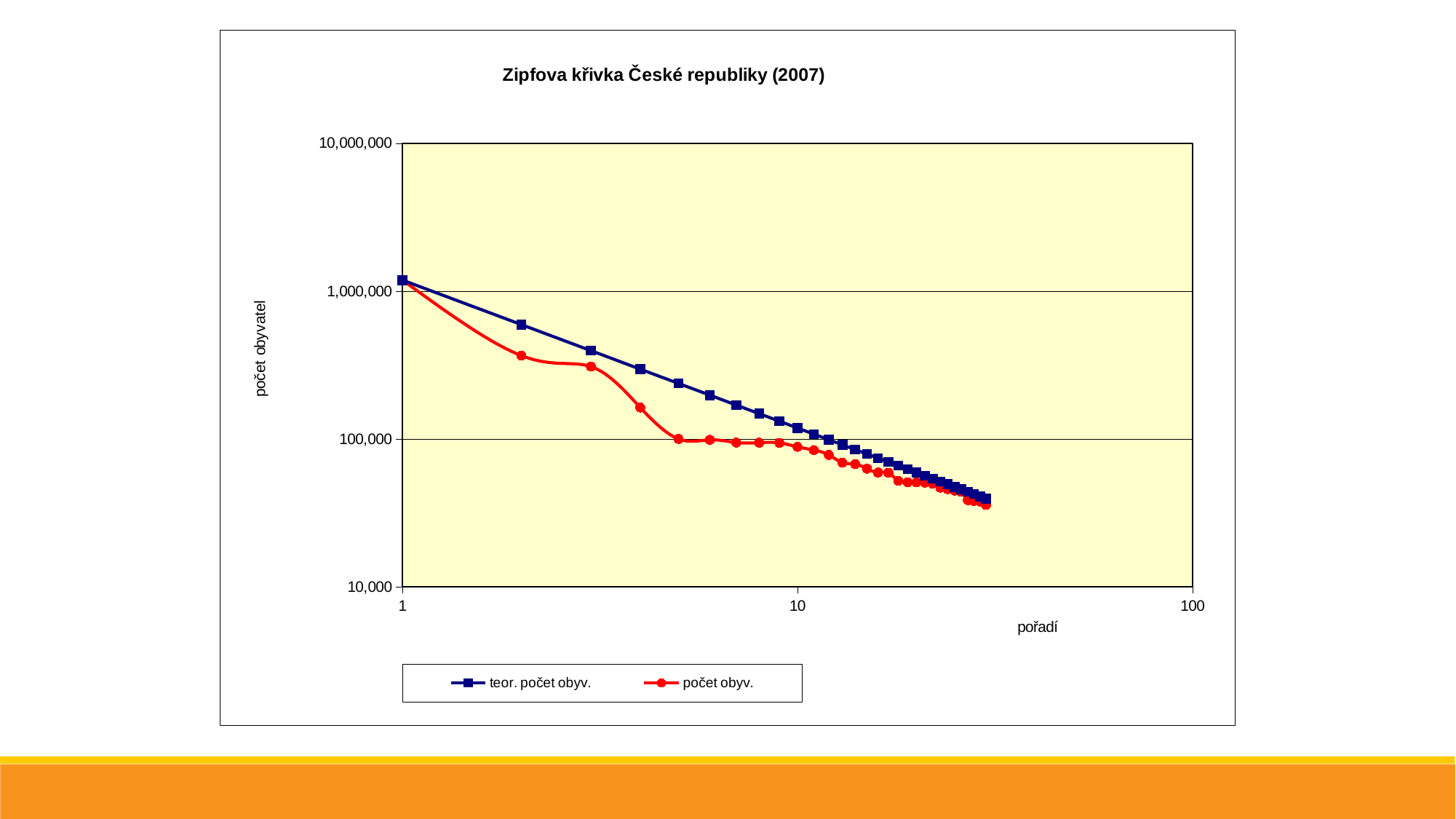
What is the title of the chart? Zipfova křivka České republiky (2007) How many series does the legend list? 2 At pořadí 2, which series has the larger value, 'teor. počet obyv.' or 'počet obyv.'? teor. počet obyv. Is the value of 'počet obyv.' at pořadí 2 greater or less than 100,000? greater Do the values of the 'teor. počet obyv.' series rise or fall along the x axis? fall Do the values of the 'počet obyv.' series rise or fall as pořadí increases? fall Is the value of 'teor. počet obyv.' at pořadí 2 greater or less than 1,000,000? less What kind of chart is shown on the slide? line chart Is the value of 'počet obyv.' at pořadí 1 greater or less than 1,000,000? greater What is the label of the vertical axis? počet obyvatel At pořadí 4, which series has the larger value, 'teor. počet obyv.' or 'počet obyv.'? teor. počet obyv. Which series is drawn with red circle markers? počet obyv.